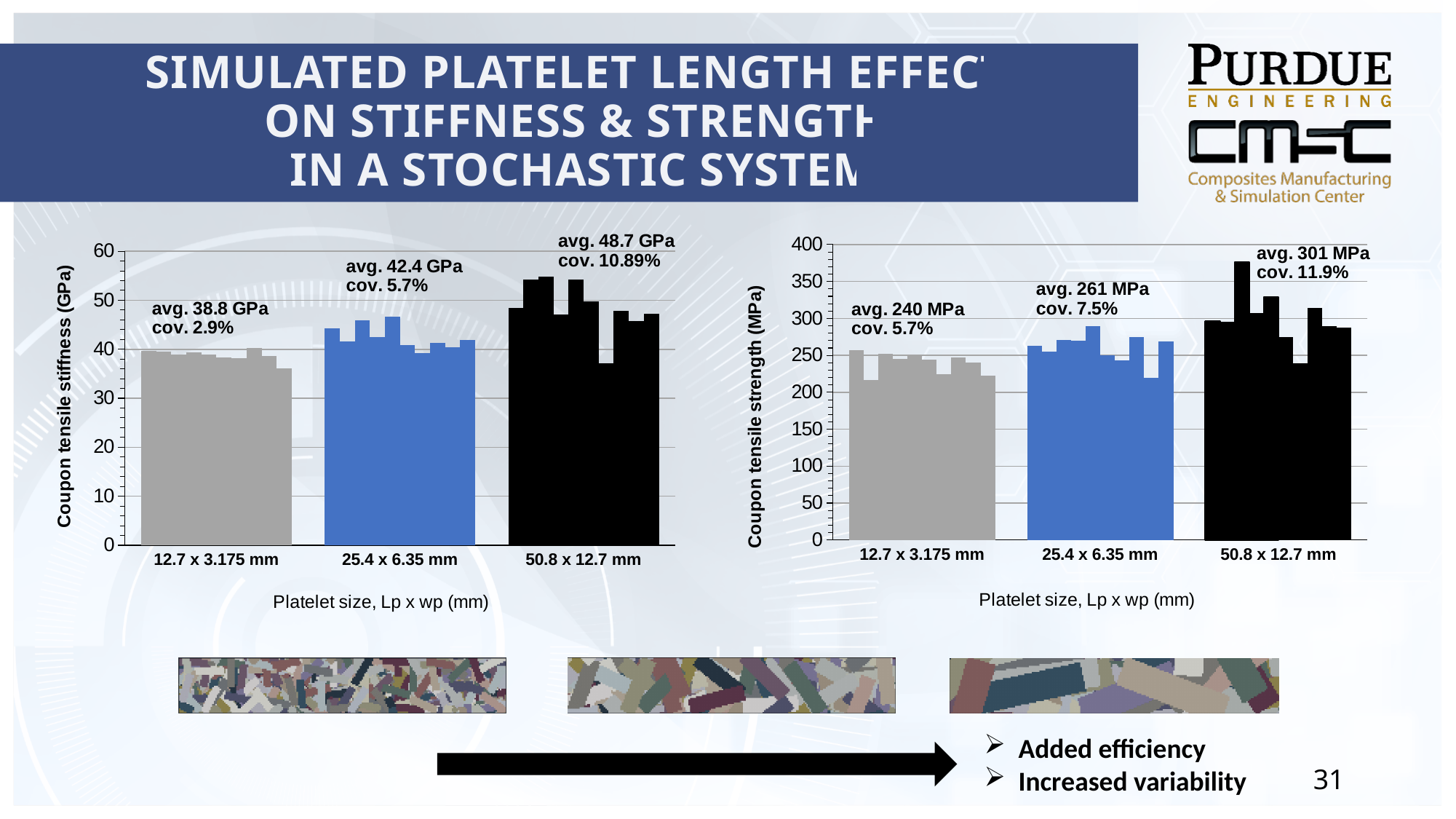
In the left chart (Coupon tensile stiffness), does the average stiffness rise or fall as platelet size increases along the x axis? Rises In the left chart (Coupon tensile stiffness), what is the average stiffness for the 12.7 x 3.175 mm platelet size? 38.8 GPa In the left chart (Coupon tensile stiffness), what is the coefficient of variation for the 50.8 x 12.7 mm platelet size? 10.89% In the left chart (Coupon tensile stiffness), what is the difference between the average stiffness for 50.8 x 12.7 mm and for 12.7 x 3.175 mm? 9.9 GPa How many platelet size categories are shown on the x axis of the left chart (Coupon tensile stiffness)? 3 What kind of chart is the right chart (Coupon tensile strength)? Bar chart In the right chart (Coupon tensile strength), what is the difference between the average strength for 50.8 x 12.7 mm and for 12.7 x 3.175 mm? 61 MPa In the right chart (Coupon tensile strength), what is the average strength for the 25.4 x 6.35 mm platelet size? 261 MPa In the right chart (Coupon tensile strength), what is the coefficient of variation for the 50.8 x 12.7 mm platelet size? 11.9% In the left chart (Coupon tensile stiffness), which platelet size has the lowest average stiffness? 12.7 x 3.175 mm In the right chart (Coupon tensile strength), which platelet size has the highest average strength? 50.8 x 12.7 mm In the right chart (Coupon tensile strength), is the coefficient of variation larger for 25.4 x 6.35 mm or for 12.7 x 3.175 mm? 25.4 x 6.35 mm